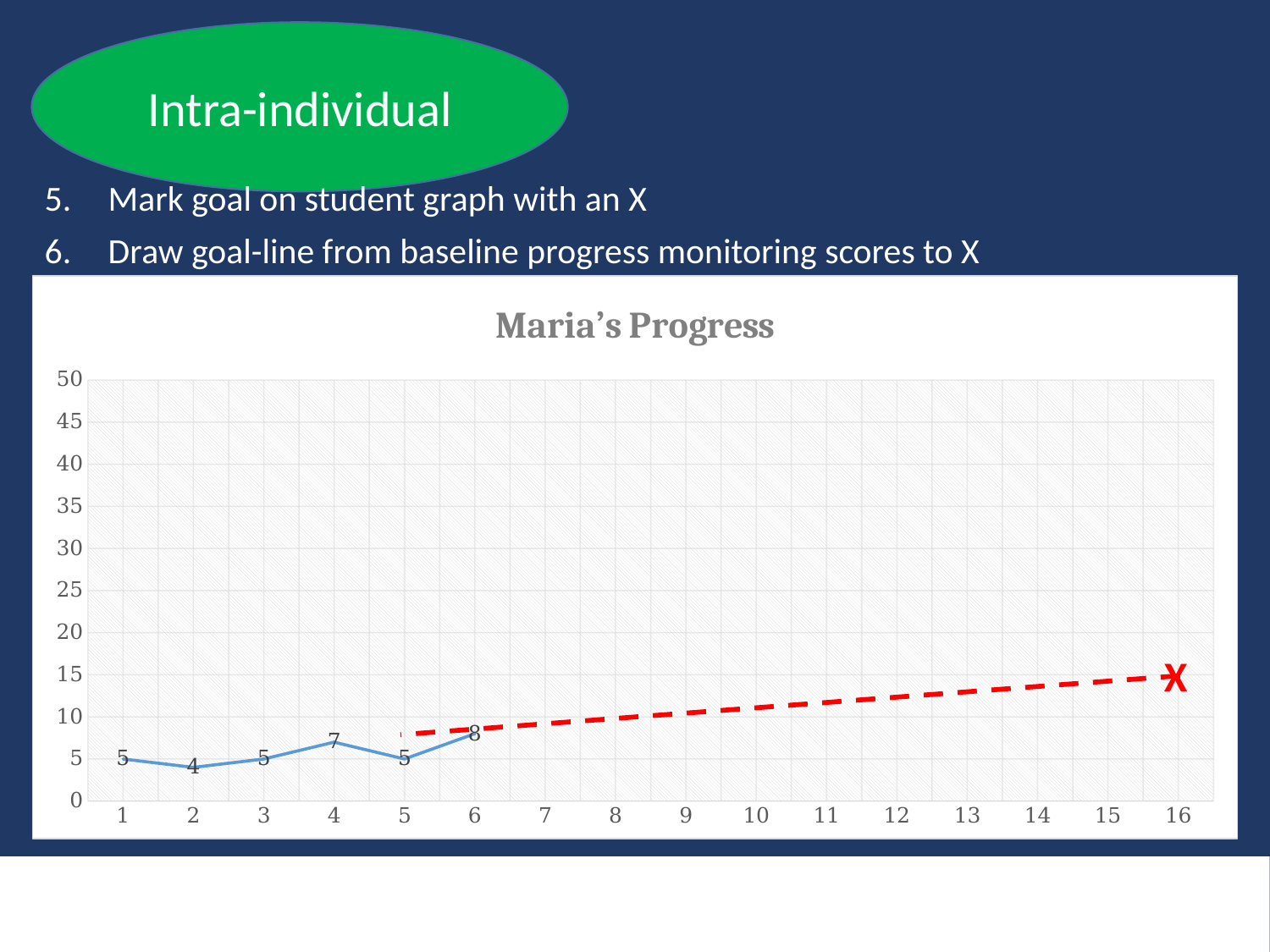
How many data points are plotted on the blue line? 6 Is the goal marked with the X at point 16 greater or less than 20? less What is the value plotted at point 4 on the x axis? 7 What is the value plotted at point 6 on the x axis? 8 What is the value plotted at point 1 on the x axis? 5 What is the title of the chart? Maria's Progress At which x-axis point is the plotted value the highest? 6 What is the difference between the value at point 6 and the value at point 2? 4 Which is larger, the value at point 4 or the value at point 5? point 4 What kind of chart is shown on the slide? line chart At which x-axis point is the plotted value the lowest? 2 What is the value plotted at point 2 on the x axis? 4